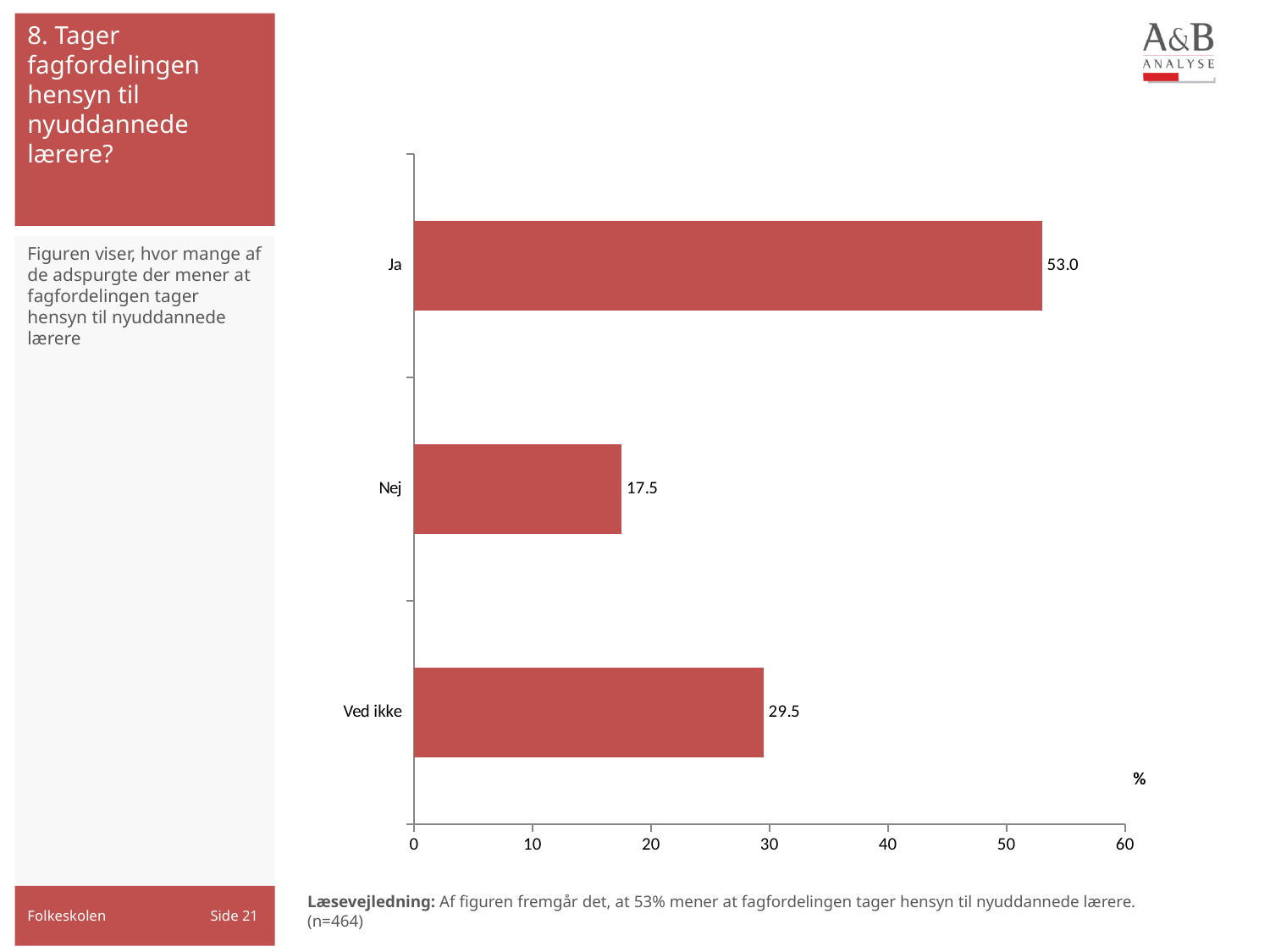
Which category has the lowest value? Nej Which category has the highest value? Ja How many categories are shown in the chart? 3 What is the value for "Ja"? 53.0 What is the value for "Nej"? 17.5 Is the value for "Ja" greater or less than 50? greater Which is larger, the value for "Ved ikke" or the value for "Nej"? Ved ikke What is the difference between the values for "Ja" and "Nej"? 35.5 What is the maximum value shown on the horizontal axis? 60 What is the value for "Ved ikke"? 29.5 What kind of chart is shown on the slide? bar chart What is the difference between the values for "Ved ikke" and "Nej"? 12.0